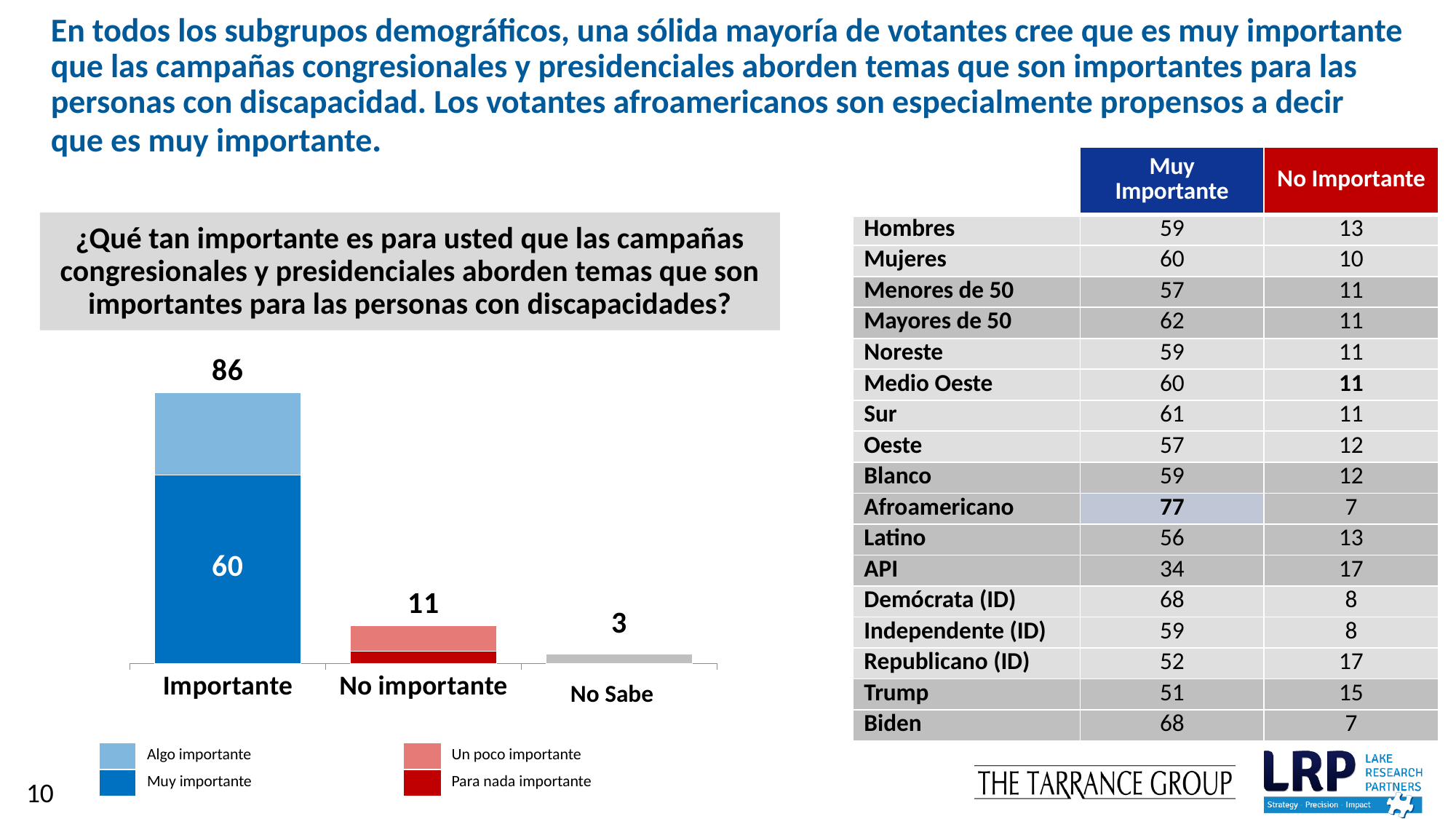
Which category has the highest value in the bar chart? Importante How many categories are shown on the x axis of the bar chart? 3 Which category has the lowest value in the bar chart? No Sabe What is the value shown for "No Sabe"? 3 What is the value shown for "No importante"? 11 How many entries does the chart legend list? 4 What is the difference between the "No importante" value and the "No Sabe" value? 8 What is the difference between the "Importante" total and the "No importante" value? 75 What kind of chart is shown on the slide? Stacked bar chart What value is printed on the "Muy importante" segment of the "Importante" bar? 60 What is the total value shown for the "Importante" bar? 86 Which is larger, the value for "No importante" or the value for "No Sabe"? No importante